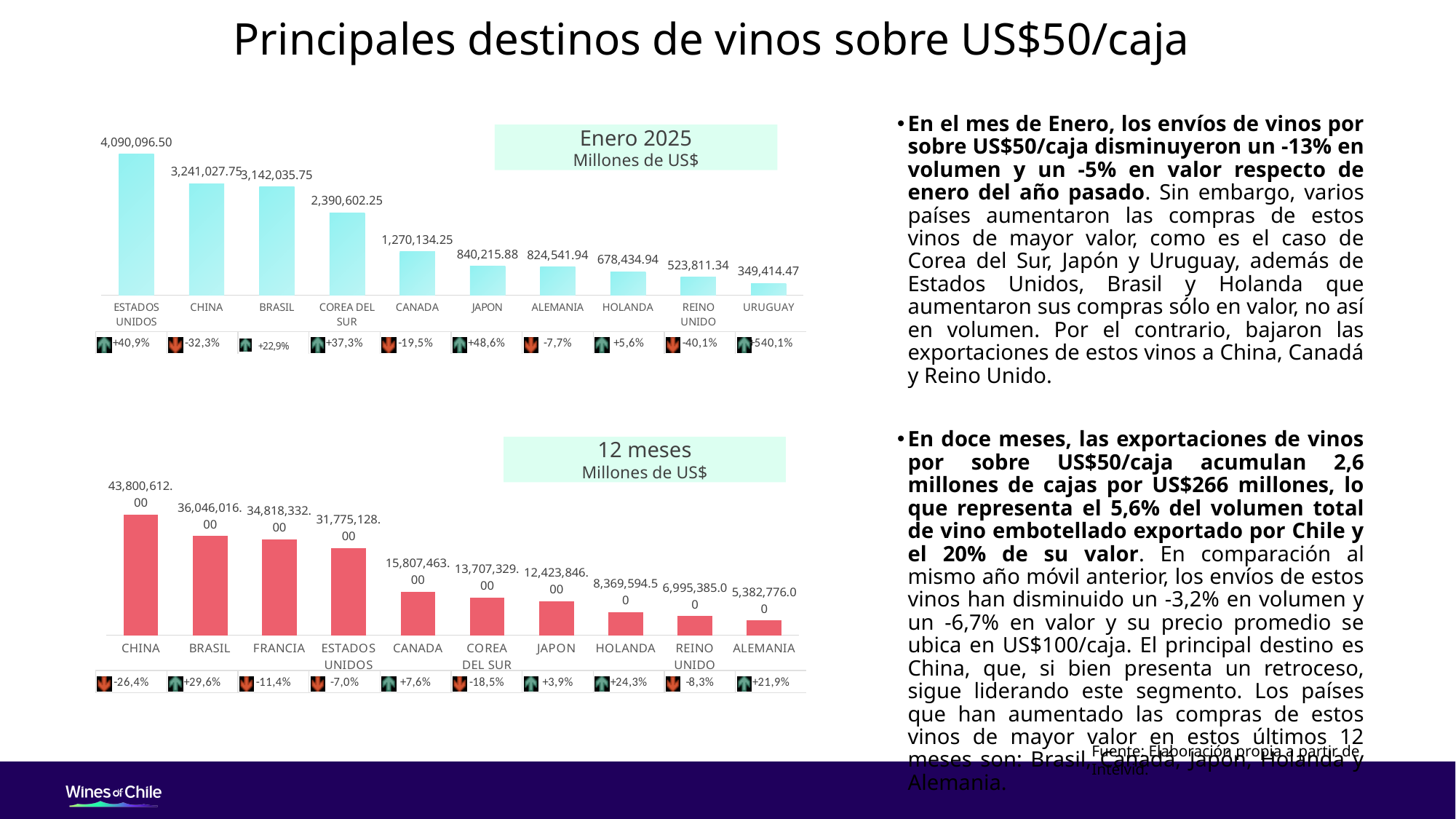
In the '12 meses' chart, which country has the highest value? CHINA In the '12 meses' chart, do the values rise or fall from left to right? Fall In the 'Enero 2025' chart, which country has the lowest value? URUGUAY In the '12 meses' chart, what is the difference between the values for CHINA and BRASIL? 7,754,596.00 In the '12 meses' chart, what is the value for HOLANDA? 8,369,594.50 What kind of chart is the '12 meses' chart? Bar chart In the 'Enero 2025' chart, what is the value for ESTADOS UNIDOS? 4,090,096.50 In the 'Enero 2025' chart, what is the value for JAPON? 840,215.88 In the '12 meses' chart, what is the value for CHINA? 43,800,612.00 In the '12 meses' chart, which is larger, the value for FRANCIA or the value for ESTADOS UNIDOS? FRANCIA In the 'Enero 2025' chart, what is the difference between the values for ESTADOS UNIDOS and CHINA? 849,068.75 In the 'Enero 2025' chart, how many countries are shown? 10